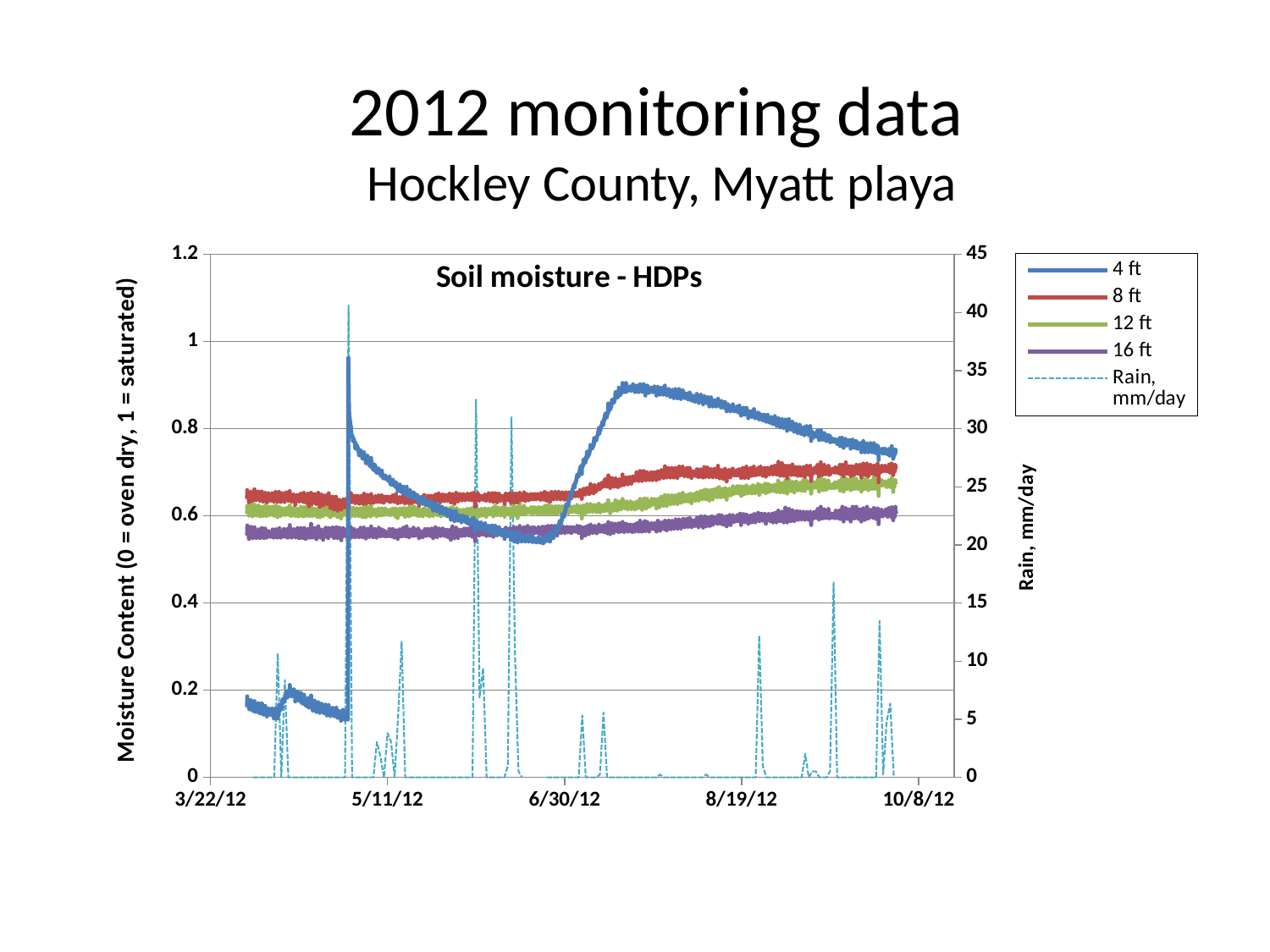
What is the label of the right-hand vertical axis? Rain, mm/day Is the 16 ft moisture content at the start of the record (late March) greater or less than 0.6? less Does the 4 ft series rise or fall from its mid-July peak to the end of the record in October? fall Is the peak value of the 4 ft series greater or less than 0.8? greater At the start of the record in late March, which is higher, the 8 ft series or the 4 ft series? 8 ft How many series does the legend list? 5 What kind of chart is shown on the slide? line chart Is the largest rain peak greater or less than 35 mm/day? greater In late July, which is higher, the 4 ft series or the 8 ft series? 4 ft What is the title of the chart? Soil moisture - HDPs Which series reaches the highest moisture content on the chart? 4 ft